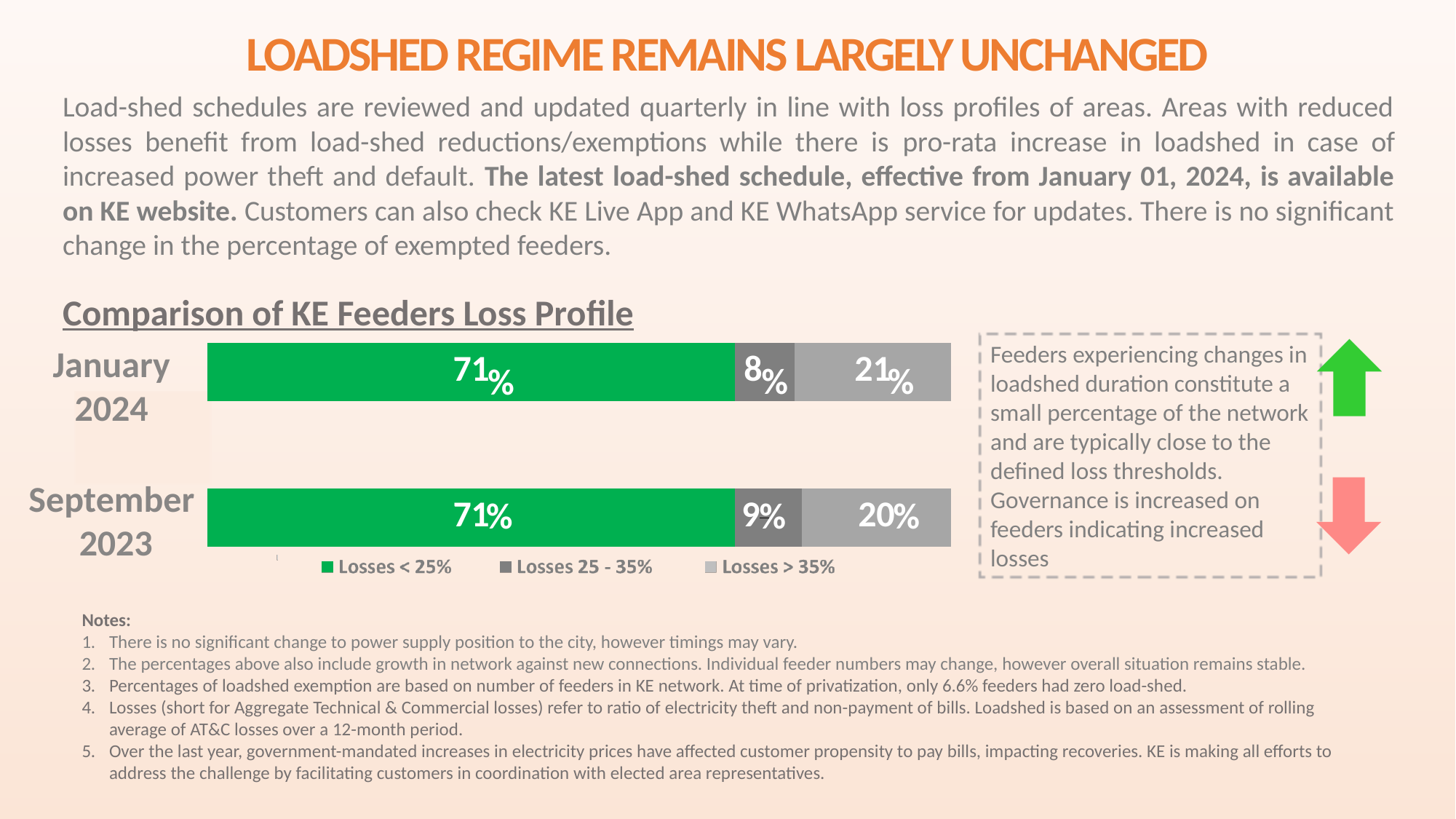
What percentage of feeders had losses below 25% in January 2024? 71% What is the value for Losses 25 - 35% in September 2023? 9% Which loss category has the largest share of feeders in January 2024? Losses < 25% What is the difference between the Losses > 35% share in January 2024 and in September 2023? 1% Which loss category has the smallest share of feeders in September 2023? Losses 25 - 35% What is the title of the chart? Comparison of KE Feeders Loss Profile What kind of chart is used to compare the KE feeders loss profile? Stacked bar chart What percentage of feeders had losses above 35% in September 2023? 20% What is the value for Losses 25 - 35% in January 2024? 8% How many time periods are compared in the chart? 2 How many series does the legend list? 3 Is the Losses > 35% share larger in January 2024 or in September 2023? January 2024